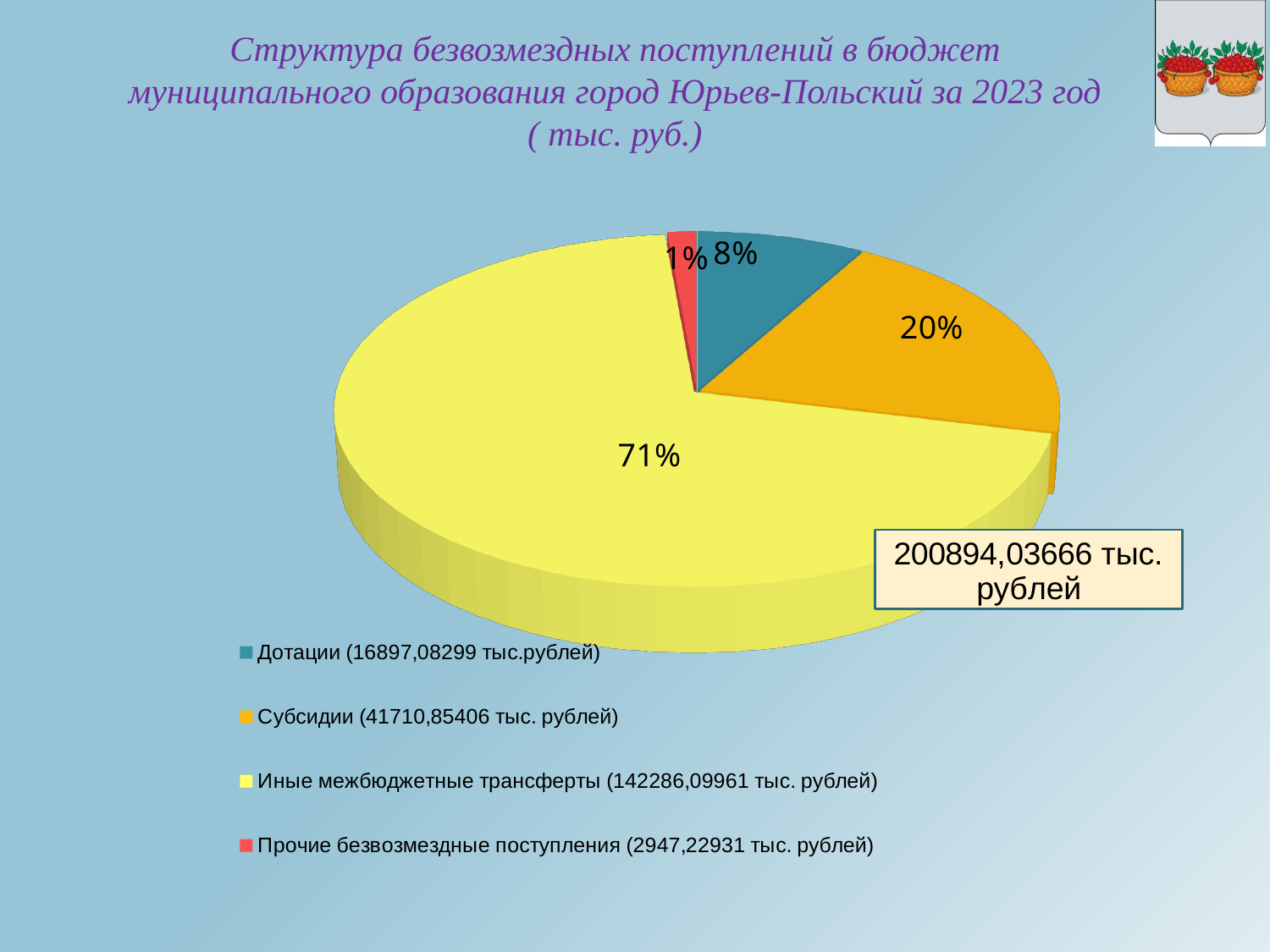
What colour is the slice for Дотации? teal How many slices does the pie chart have? 4 What share of the pie does Прочие безвозмездные поступления have? 1% Which is larger, the slice for Субсидии or the slice for Дотации? Субсидии What is the difference in percentage points between the Иные межбюджетные трансферты slice and the Субсидии slice? 51 What share of the pie does Субсидии have? 20% What kind of chart is shown on the slide? pie chart What share of the pie does Иные межбюджетные трансферты have? 71% Which category has the largest slice of the pie? Иные межбюджетные трансферты Which category has the smallest slice of the pie? Прочие безвозмездные поступления What total amount is shown in the box next to the pie chart? 200894,03666 тыс. рублей